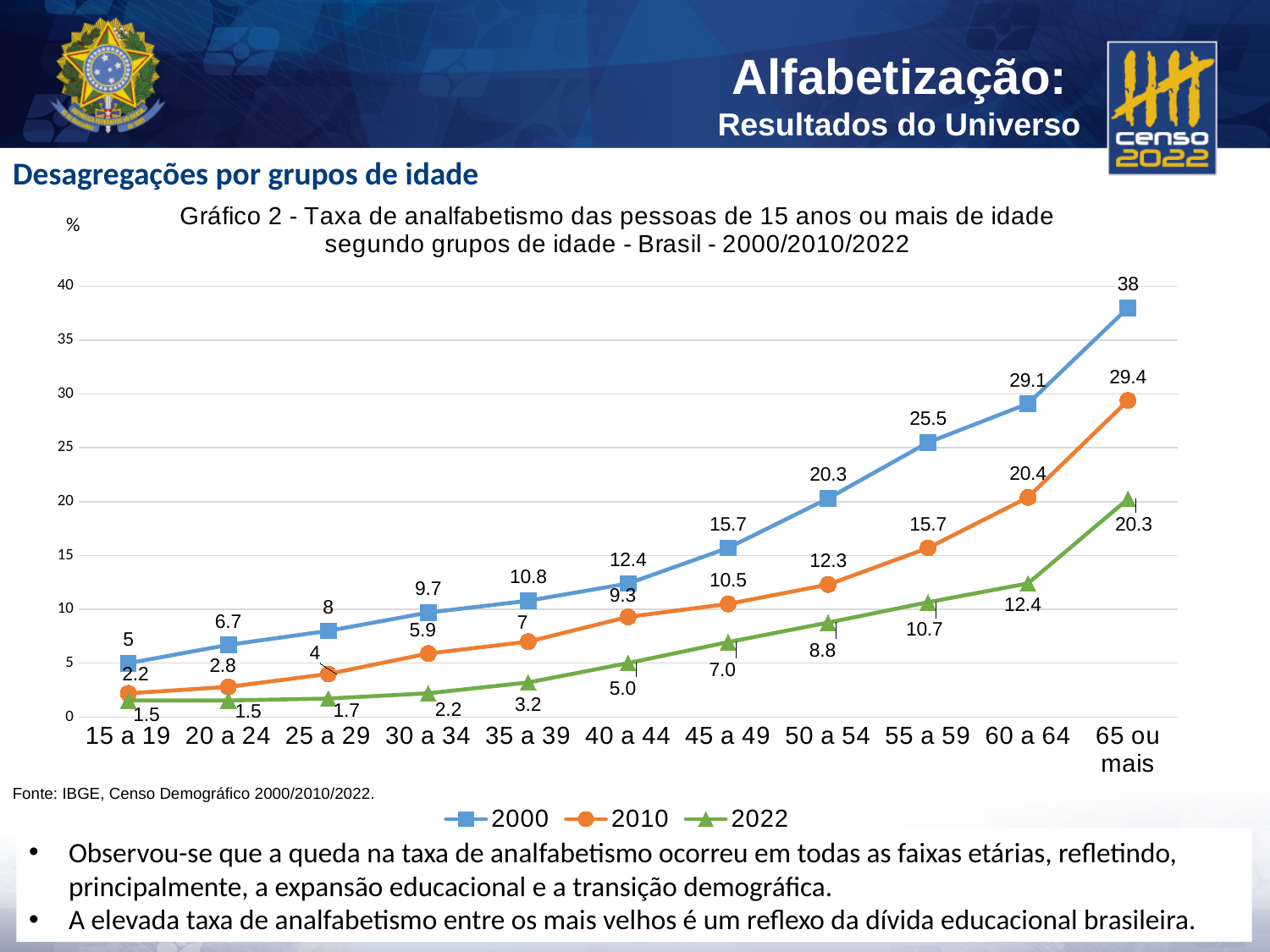
What is the value for the 2000 series in the 65 ou mais age group? 38 Which is larger for the 60 a 64 age group: the 2000 value or the 2010 value? 2000 What is the difference between the 2000 and 2022 values for the 65 ou mais age group? 17.7 How many series does the legend list? 3 What unit is shown on the vertical axis of the chart? % What is the value for the 2022 series in the 40 a 44 age group? 5.0 How many age groups are plotted along the x axis? 11 Do the values of the 2000 series rise or fall as the age groups increase along the x axis? rise What is the value for the 2010 series in the 55 a 59 age group? 15.7 Which age group has the highest value for the 2022 series? 65 ou mais What type of chart is shown on the slide? line chart Which age group has the lowest value for the 2010 series? 15 a 19